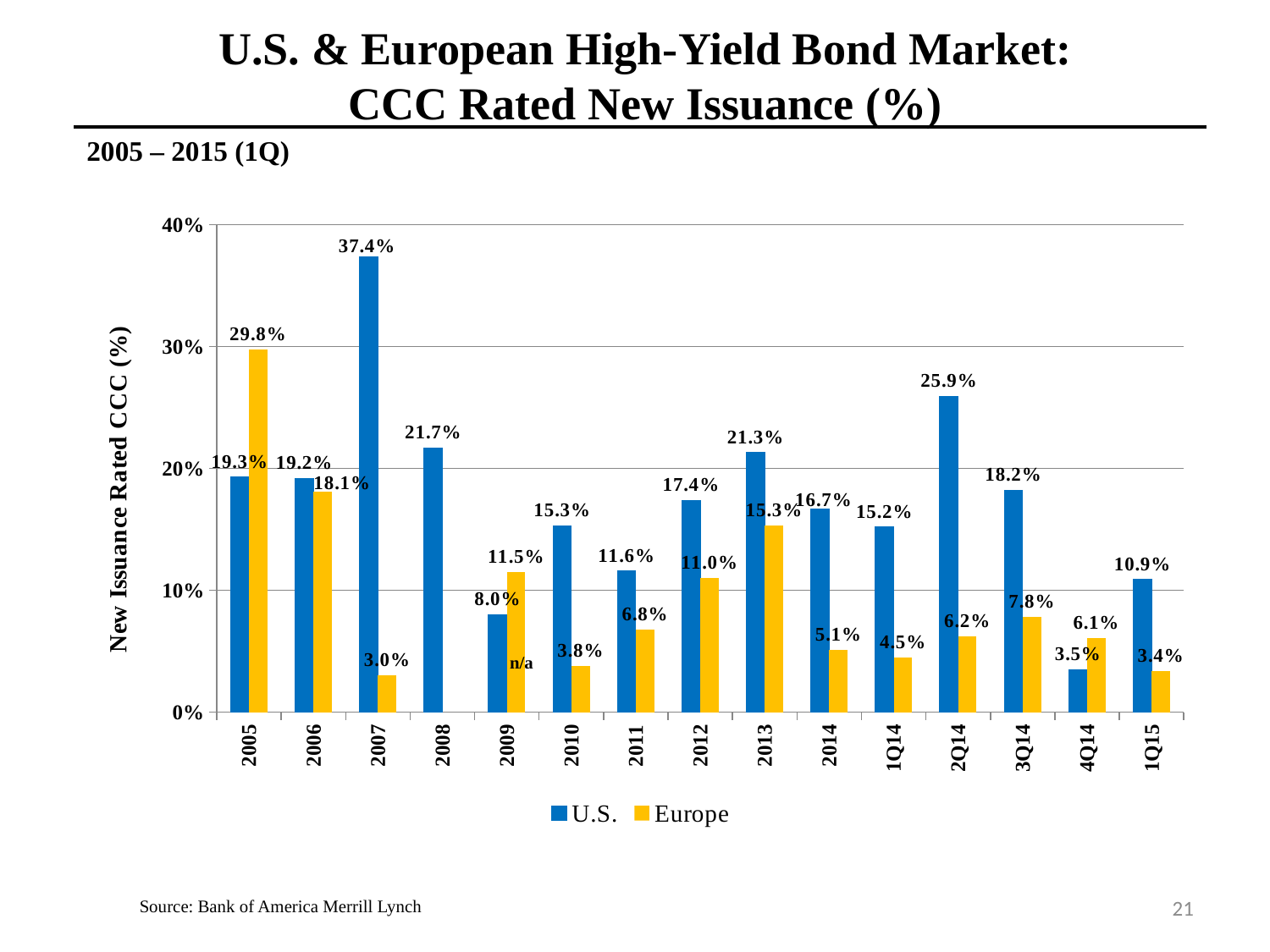
Which category has the highest U.S. value? 2007 What is the difference between the U.S. and Europe values for 2013? 6.0% What is the Europe value for 3Q14? 7.8% How many categories are shown on the x axis? 15 What kind of chart is shown on the slide? Bar chart What is the Europe value for 2005? 29.8% Which category has the lowest U.S. value? 4Q14 What is the U.S. CCC rated new issuance percentage for 2007? 37.4% Which is larger for 2009, the U.S. value or the Europe value? Europe What is the U.S. value for 1Q15? 10.9% How many series does the legend list? 2